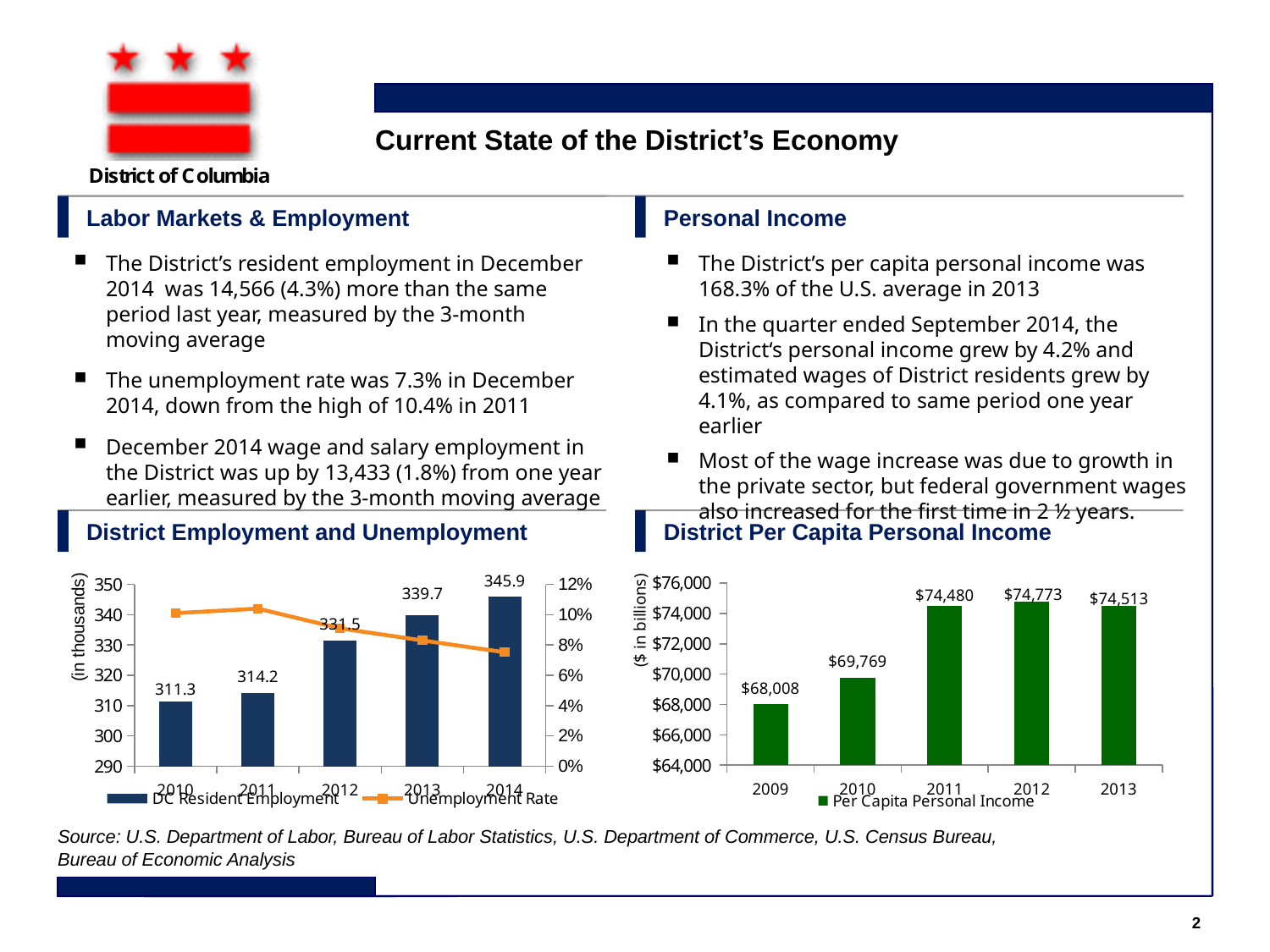
In the District Employment and Unemployment chart, does the Unemployment Rate rise or fall from 2011 to 2014? fall In the District Per Capita Personal Income chart, what was per capita personal income in 2012? $74,773 In the District Employment and Unemployment chart, by how much did DC Resident Employment increase from 2011 to 2012? 17.3 What type of chart is the District Per Capita Personal Income chart? bar chart In the District Per Capita Personal Income chart, what is the difference between per capita personal income in 2010 and 2009? $1,761 In the District Per Capita Personal Income chart, which year has the lowest per capita personal income? 2009 In the District Employment and Unemployment chart, what was DC Resident Employment in 2014? 345.9 In the District Employment and Unemployment chart, is the Unemployment Rate for 2014 greater or less than 8%? less In the District Employment and Unemployment chart, how many series does the legend list? 2 In the District Per Capita Personal Income chart, how many years are shown? 5 In the District Employment and Unemployment chart, which year has the highest DC Resident Employment? 2014 In the District Employment and Unemployment chart, what was DC Resident Employment in 2010? 311.3